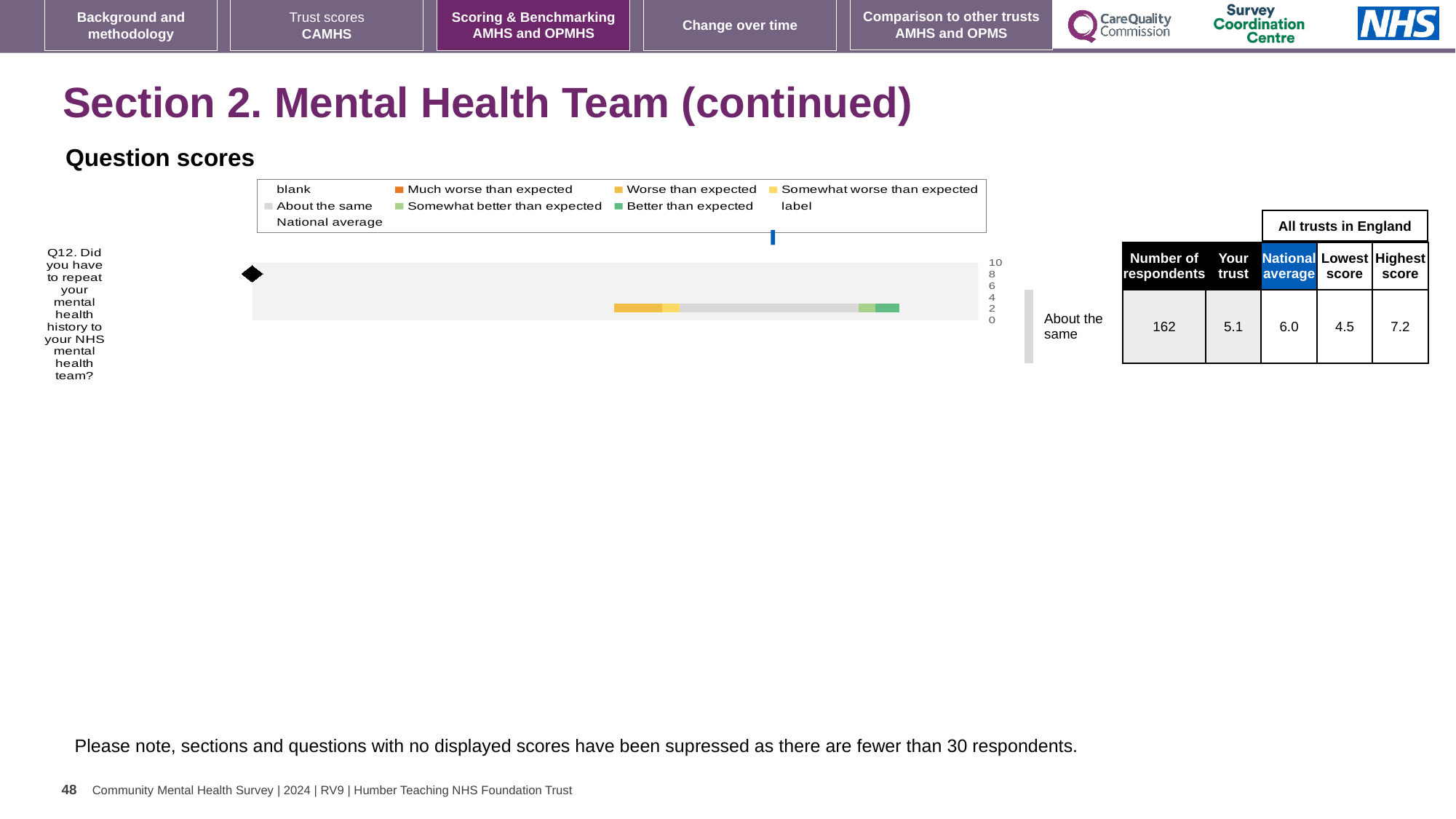
In the table beside the chart, what is the national average score for Q12? 6.0 What kind of chart is used to show the question scores? bar chart What is the benchmark category shown for Q12 in the question scores chart? About the same In the table beside the chart, what is the highest score among all trusts in England for Q12? 7.2 Which question is shown in the question scores chart? Q12. Did you have to repeat your mental health history to your NHS mental health team? What colour represents 'Better than expected' in the chart legend? green In the table beside the chart, what is the lowest score among all trusts in England for Q12? 4.5 How many questions are plotted in the question scores chart? 1 For Q12, which is larger: the 'Your trust' score or the national average? National average How many respondents answered Q12 according to the table beside the chart? 162 In the table beside the chart, what is the 'Your trust' score for Q12? 5.1 What is the difference between the highest score and the lowest score for Q12? 2.7